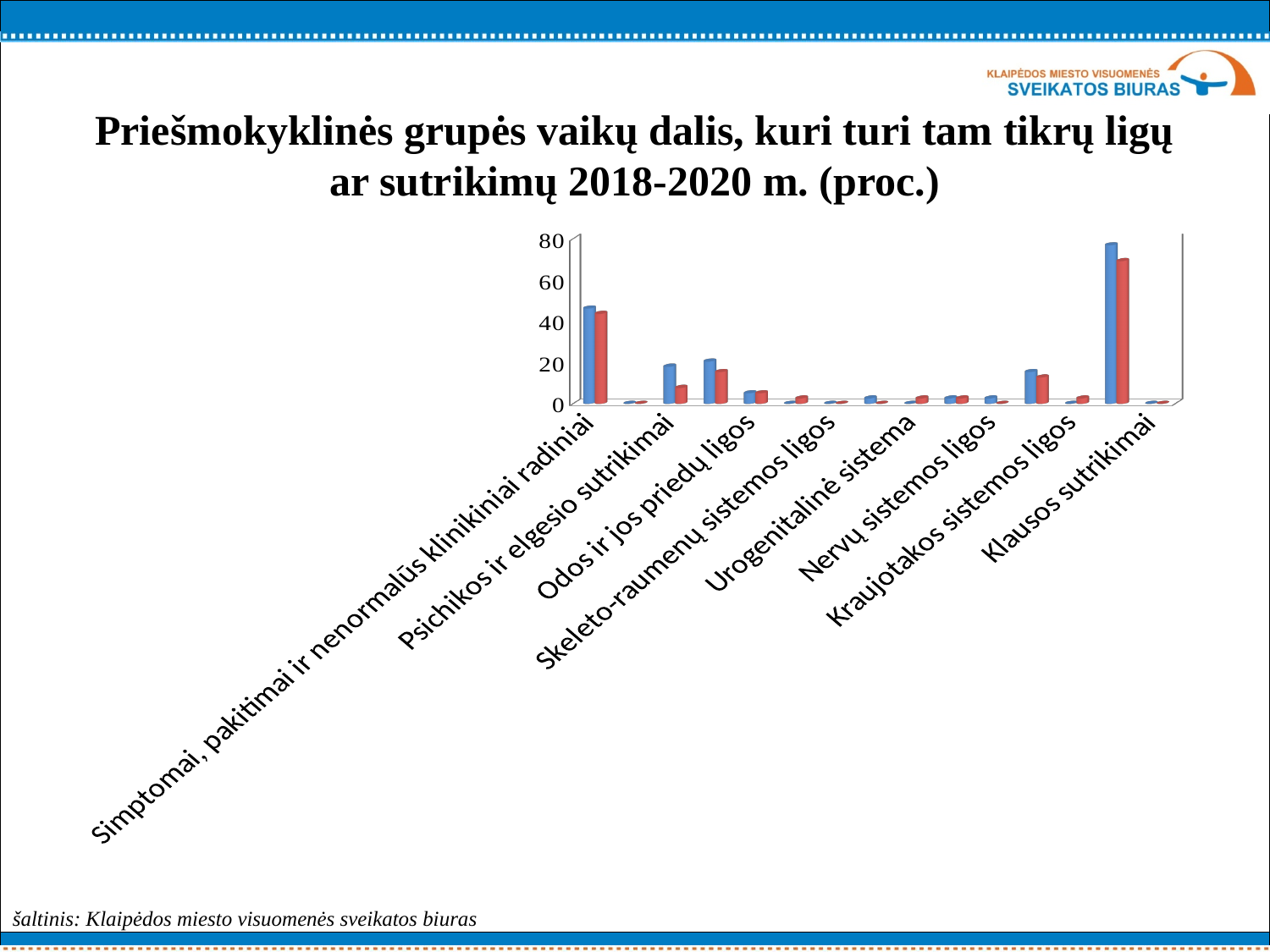
What is the highest value shown on the vertical axis of the chart? 80 Is the value of the blue bar for 'Simptomai, pakitimai ir nenormalūs klinikiniai radiniai' greater or less than 60? less Is the value of the red bar for 'Psichikos ir elgesio sutrikimai' greater or less than 20? less Which has a taller blue bar: 'Simptomai, pakitimai ir nenormalūs klinikiniai radiniai' or 'Psichikos ir elgesio sutrikimai'? Simptomai, pakitimai ir nenormalūs klinikiniai radiniai Is the value of the blue bar for 'Simptomai, pakitimai ir nenormalūs klinikiniai radiniai' greater or less than 40? greater What kind of chart is shown on the slide? bar chart For 'Psichikos ir elgesio sutrikimai', which bar is taller, the blue one or the red one? the blue one What is the title of the chart on the slide? Priešmokyklinės grupės vaikų dalis, kuri turi tam tikrų ligų ar sutrikimų 2018-2020 m. (proc.)